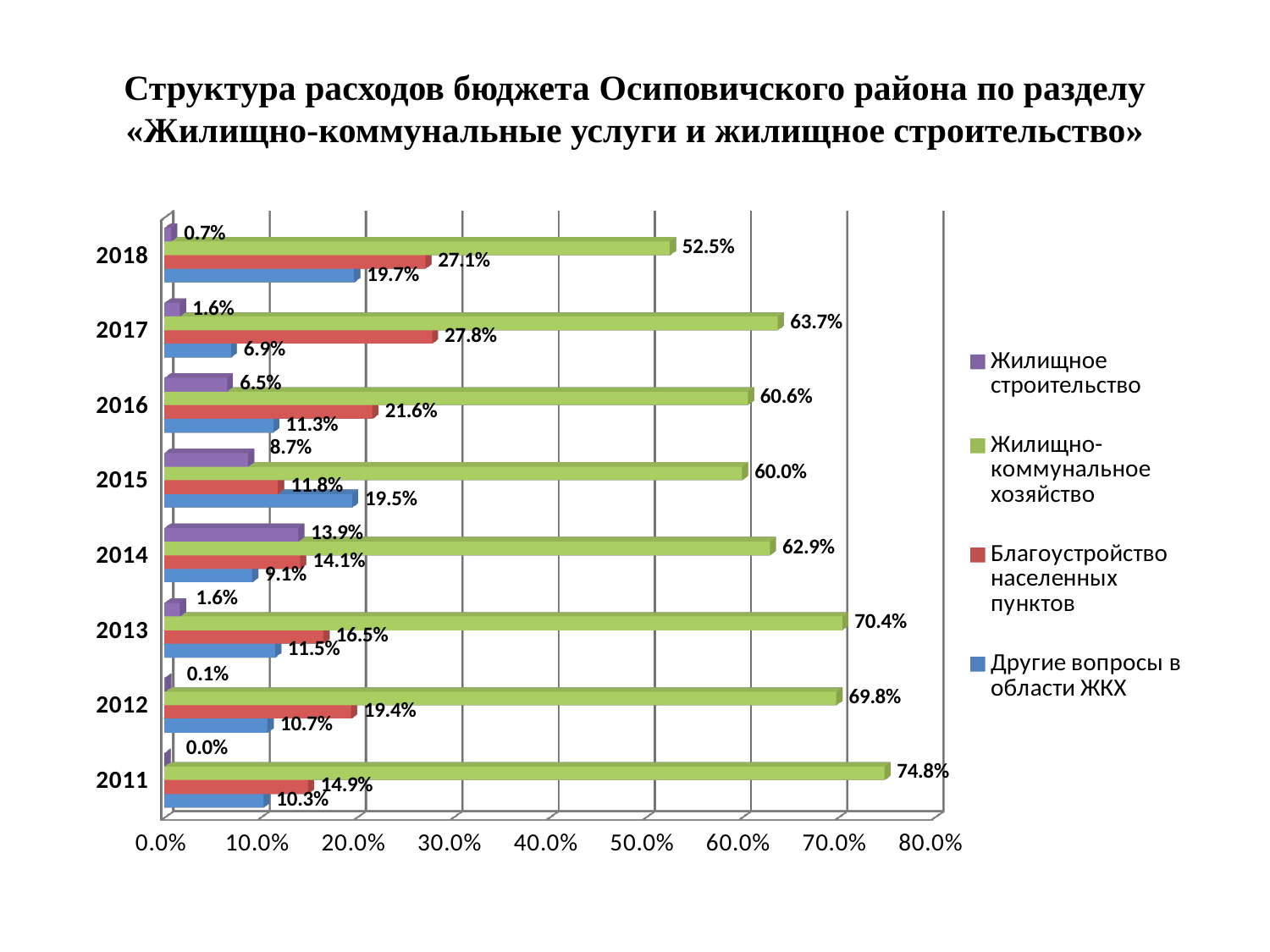
In which year is the value for Жилищное строительство the highest? 2014 Which is larger in 2016: Благоустройство населенных пунктов or Другие вопросы в области ЖКХ? Благоустройство населенных пунктов How many years are shown on the chart? 8 In which year is the value for Жилищно-коммунальное хозяйство the lowest? 2018 How many series does the legend list? 4 What is the value for Благоустройство населенных пунктов in 2017? 27.8% What is the value for Жилищное строительство in 2014? 13.9% What is the value for Жилищно-коммунальное хозяйство in 2018? 52.5% In which year is the value for Жилищно-коммунальное хозяйство the highest? 2011 What is the difference between the Жилищно-коммунальное хозяйство values for 2011 and 2018? 22.3% What is the value for Другие вопросы в области ЖКХ in 2015? 19.5% What kind of chart is shown on the slide? Bar chart